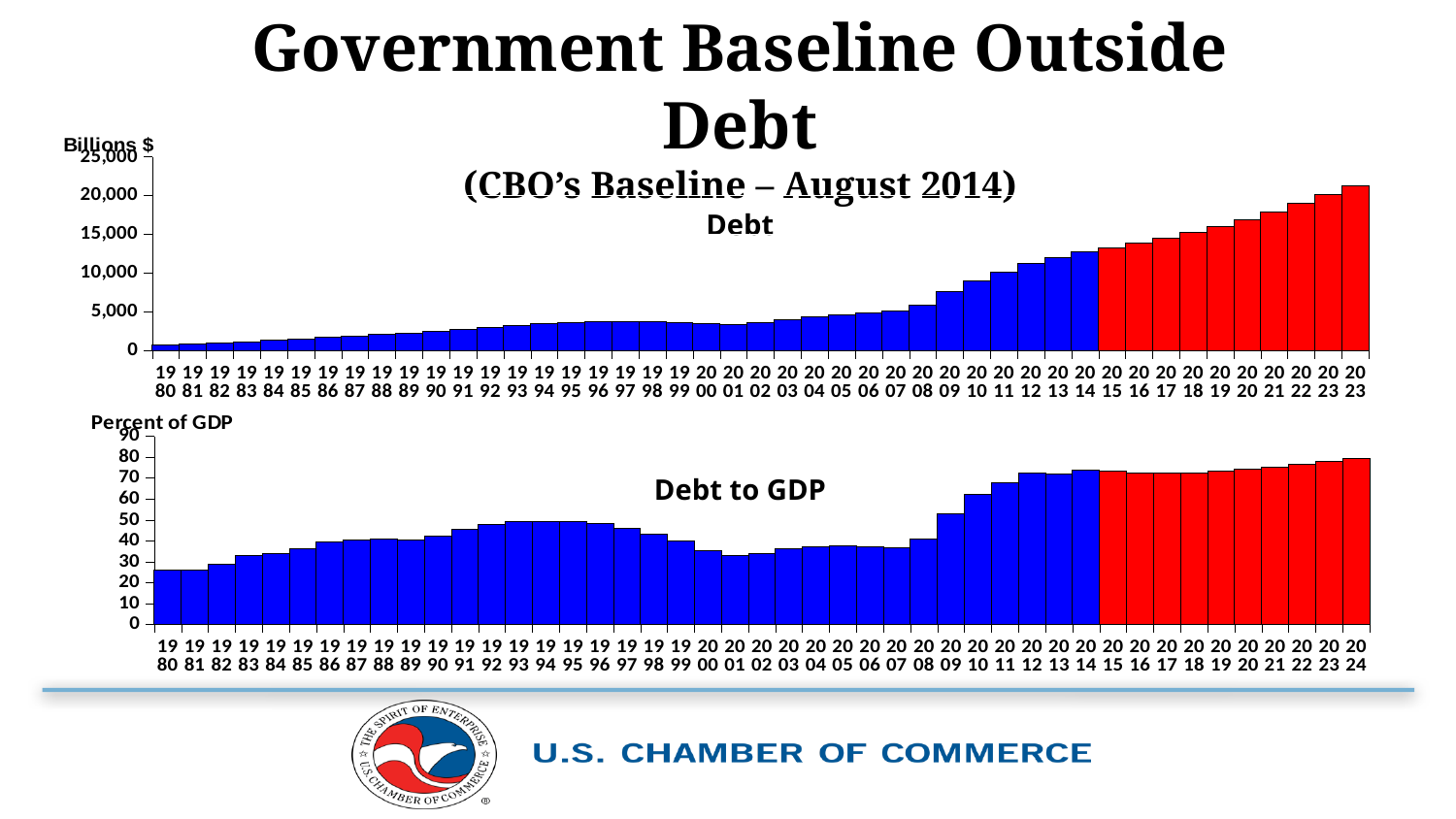
What kind of chart is the top 'Debt' chart? bar chart In the top 'Debt' chart, do the values generally rise or fall from 1980 to 2023? rise In the top 'Debt' chart, which year has the lowest debt? 1980 In the top 'Debt' chart, is the value for 2014 greater or less than 10,000? greater In the bottom 'Debt to GDP' chart, which is larger, the value for 2009 or the value for 2001? 2009 In the top 'Debt' chart, is the value for 2000 greater or less than 5,000? less What is the y-axis label of the top 'Debt' chart? Billions $ What is the y-axis label of the bottom 'Debt to GDP' chart? Percent of GDP In the top 'Debt' chart, which year has the highest debt? 2023 In the bottom 'Debt to GDP' chart, is the value for 2011 greater or less than 70? less